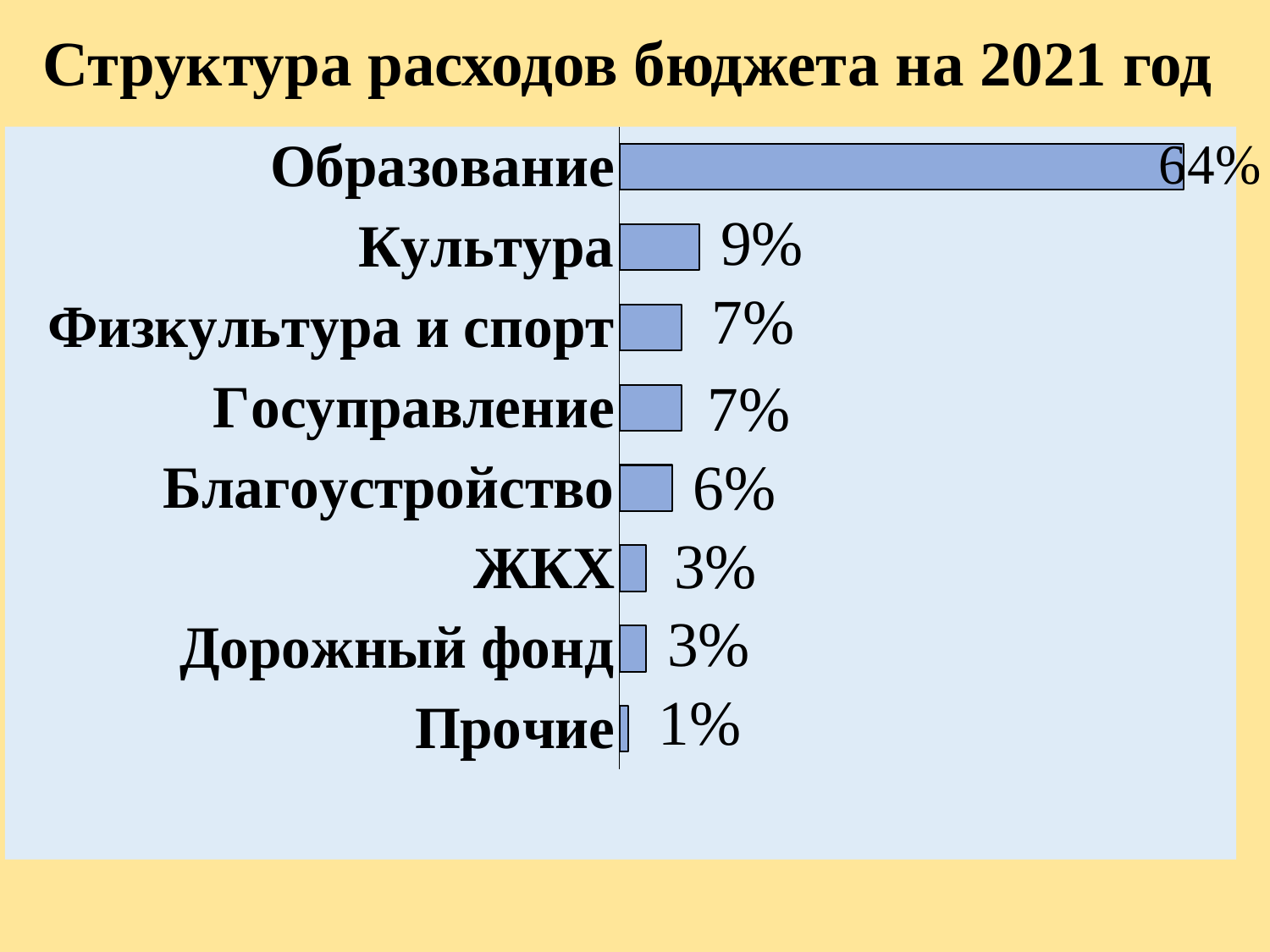
What is the value for Образование? 64% What is the value for Культура? 9% What is the value for Прочие? 1% Which is larger, the value for Культура or the value for ЖКХ? Культура What is the value for Благоустройство? 6% How many categories are shown in the chart? 8 Which category has the highest value? Образование Which category has the lowest value? Прочие What kind of chart is shown on the slide? bar chart What is the difference between the values for Образование and Культура? 55% What is the title of the slide? Структура расходов бюджета на 2021 год What is the difference between the values for Культура and Благоустройство? 3%